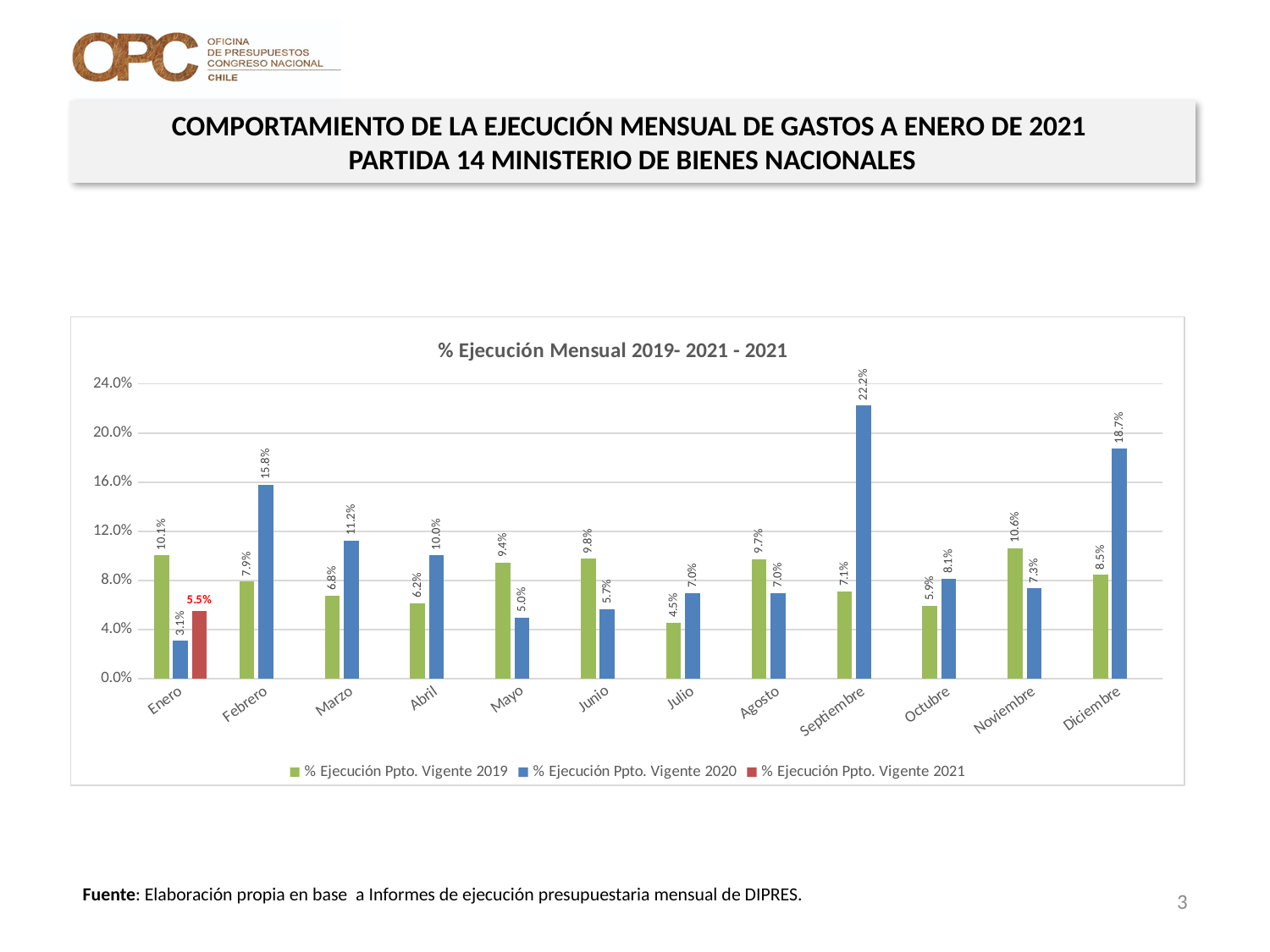
Which month has the lowest value for % Ejecución Ppto. Vigente 2019? Julio Which is larger for Mayo: % Ejecución Ppto. Vigente 2019 or % Ejecución Ppto. Vigente 2020? % Ejecución Ppto. Vigente 2019 What is the value of % Ejecución Ppto. Vigente 2020 for Septiembre? 22.2% What kind of chart is shown? Bar chart How many months are shown on the x axis? 12 Is the value of % Ejecución Ppto. Vigente 2020 for Febrero greater or less than 12.0%? greater What is the title of the chart? % Ejecución Mensual 2019- 2021 - 2021 Which month has the highest value for % Ejecución Ppto. Vigente 2020? Septiembre What is the value of % Ejecución Ppto. Vigente 2021 for Enero? 5.5% What is the difference between the 2020 and 2019 values for Diciembre? 10.2% What is the value of % Ejecución Ppto. Vigente 2019 for Noviembre? 10.6% How many series does the legend list? 3